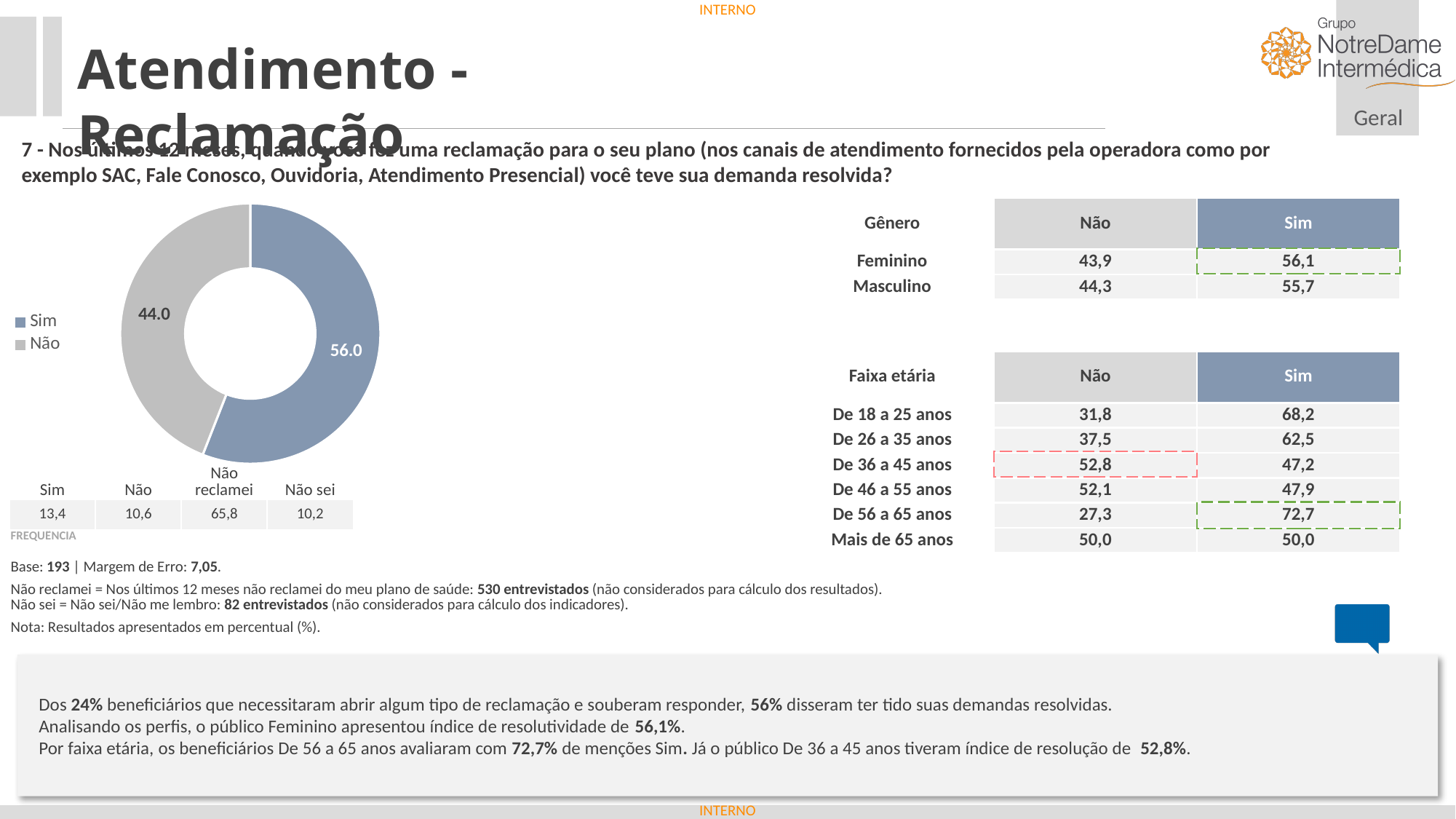
What value is shown for the Não slice of the donut chart? 44.0 What value is shown for the Sim slice of the donut chart? 56.0 What are the two legend entries of the donut chart? Sim and Não What kind of chart is shown on the left of the slide? Pie (donut) chart What is the difference between the Sim and Não values in the donut chart? 12.0 Which slice of the donut chart is the smallest? Não Which slice of the donut chart is the largest? Sim How many entries does the legend of the donut chart list? 2 What colour is the Sim slice in the donut chart? Blue In the donut chart, which is larger, Sim or Não? Sim Is the value for Sim in the donut chart greater or less than 50? greater How many slices does the donut chart have? 2